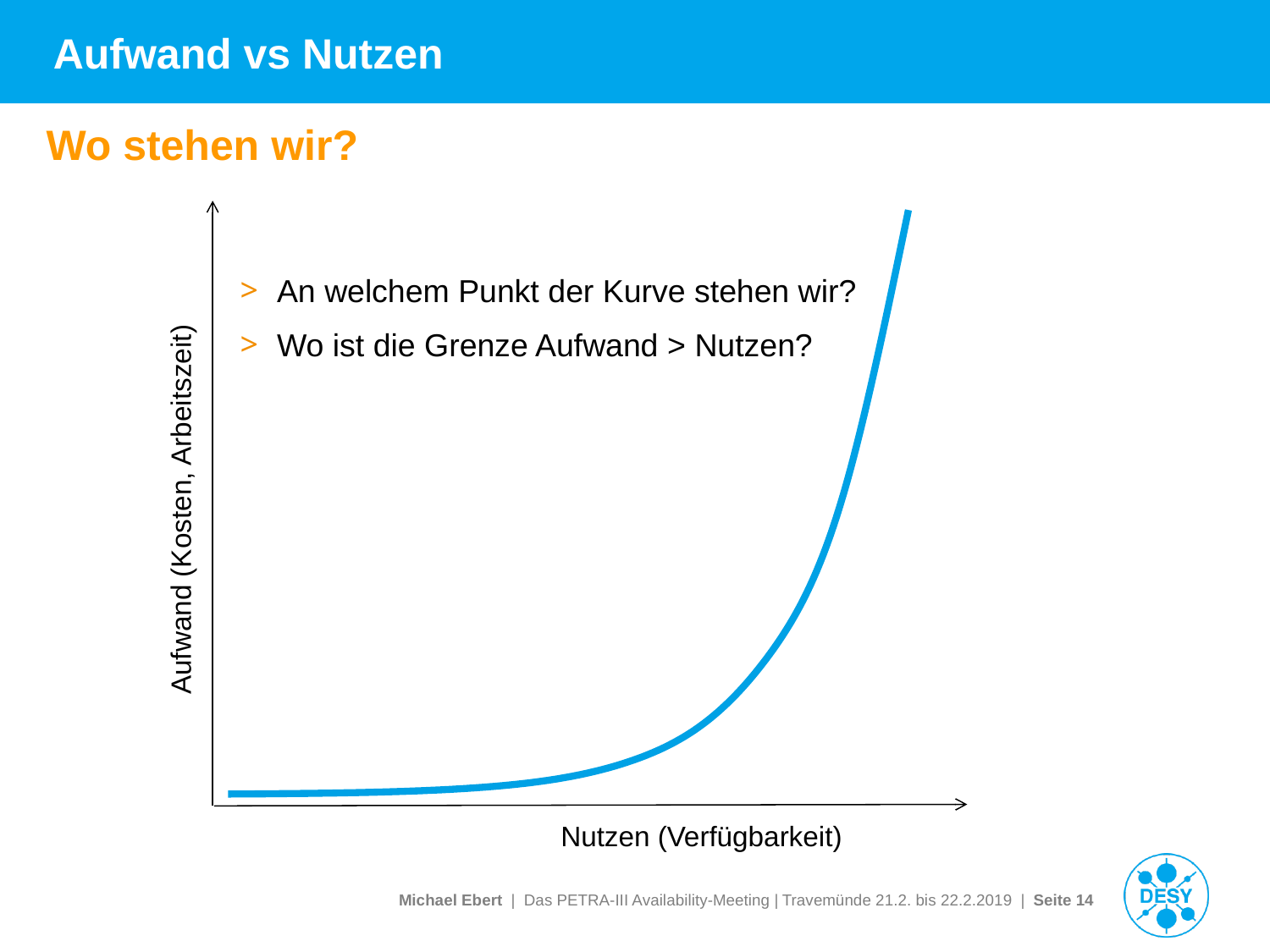
How many lines are plotted on the chart? 1 Does the curve rise or fall as you move from left to right along the x axis? rise Does the curve rise more steeply at the left end or at the right end of the x axis? right end What is the label of the y axis of the chart? Aufwand (Kosten, Arbeitszeit) What is the label of the x axis of the chart? Nutzen (Verfügbarkeit) What kind of chart is shown on the slide? line chart